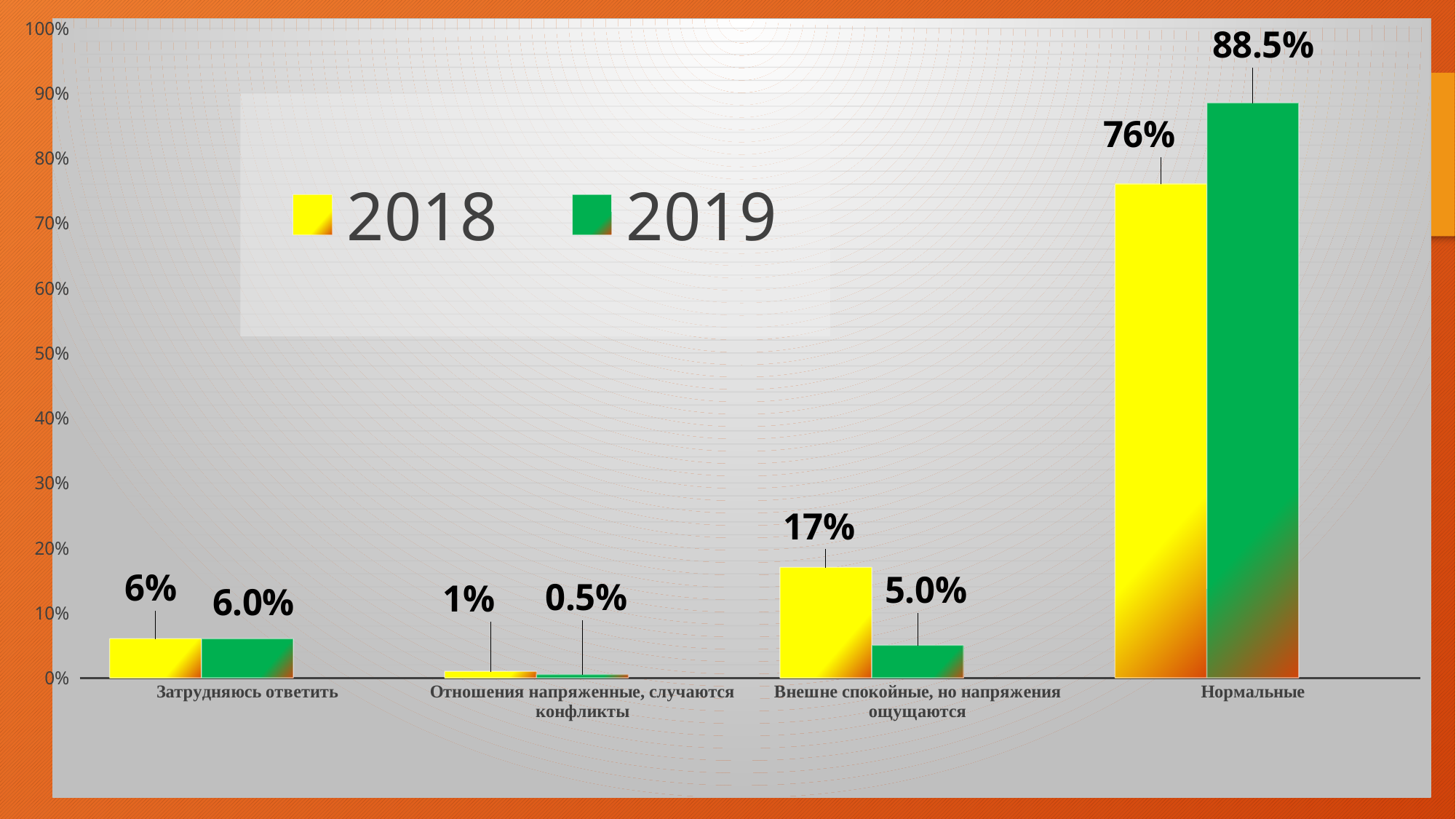
How many series does the legend list? 2 What is the 2019 value for Внешне спокойные, но напряжения ощущаются? 5.0% What kind of chart is shown on the slide? Bar chart What is the 2018 value for Отношения напряженные, случаются конфликты? 1% What is the 2019 value for Нормальные? 88.5% What is the difference between the 2019 and 2018 values for Нормальные? 12.5% Which category has the lowest 2018 value? Отношения напряженные, случаются конфликты Which is larger for Внешне спокойные, но напряжения ощущаются: the 2018 value or the 2019 value? 2018 How many categories are shown on the x axis? 4 What is the 2018 value for Нормальные? 76% Which colour represents the 2019 series? Green Which category has the highest 2019 value? Нормальные